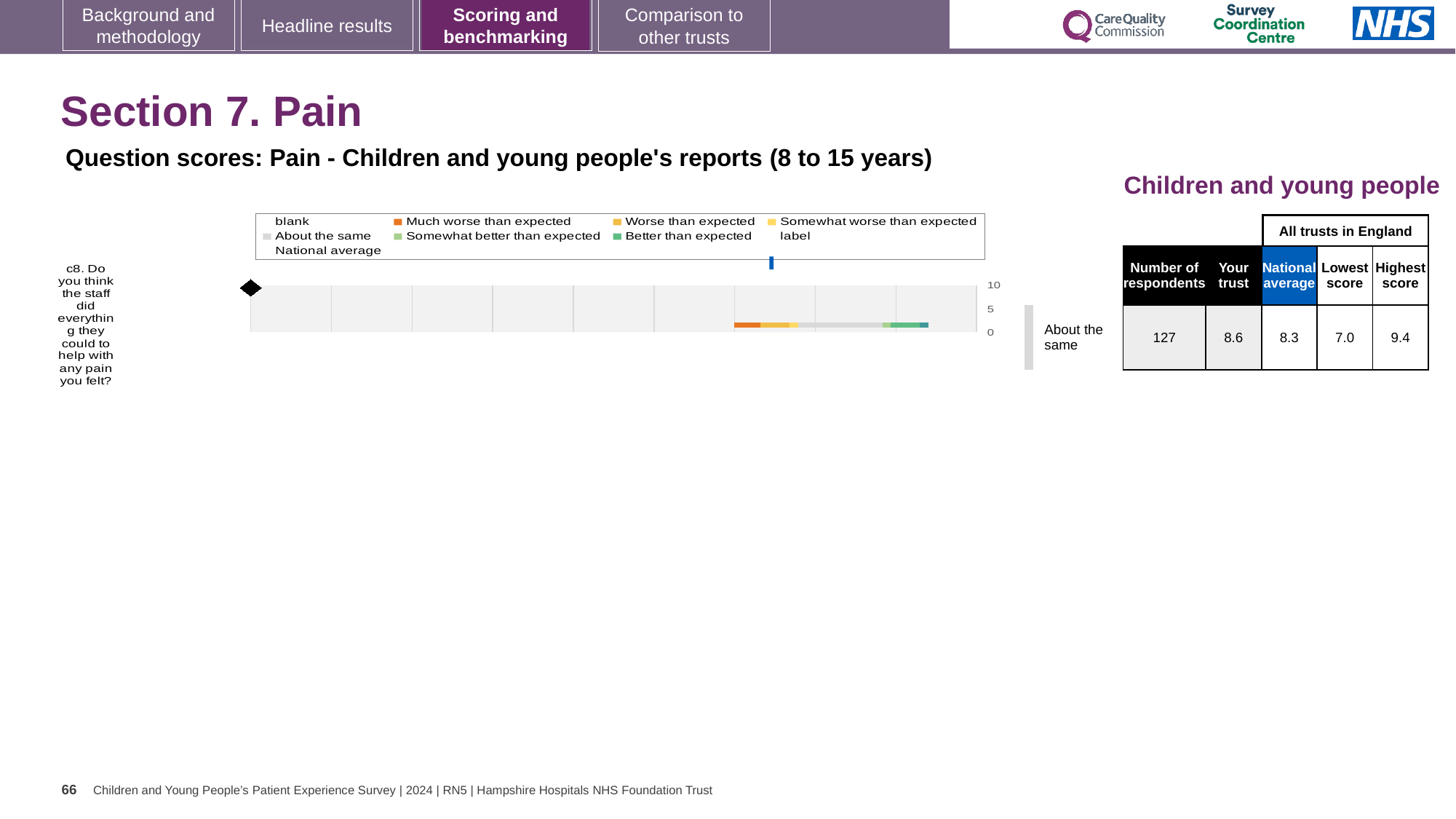
According to the table beside the chart, what is the 'Your trust' score for question c8? 8.6 What benchmark category is the trust's score for question c8 placed in? About the same How many survey questions (categories) are plotted on the chart? 1 What is the highest value shown on the chart's axis? 10 According to the table beside the chart, what is the national average score for question c8? 8.3 What is the difference between the highest score and the lowest score for question c8 in the table beside the chart? 2.4 Which survey question is plotted on the chart? c8. Do you think the staff did everything they could to help with any pain you felt? Is the trust's score for question c8 higher or lower than the national average? higher According to the table beside the chart, what is the highest score among all trusts in England for question c8? 9.4 According to the table beside the chart, how many respondents answered question c8? 127 According to the table beside the chart, what is the lowest score among all trusts in England for question c8? 7.0 What kind of chart is shown on the slide? bar chart